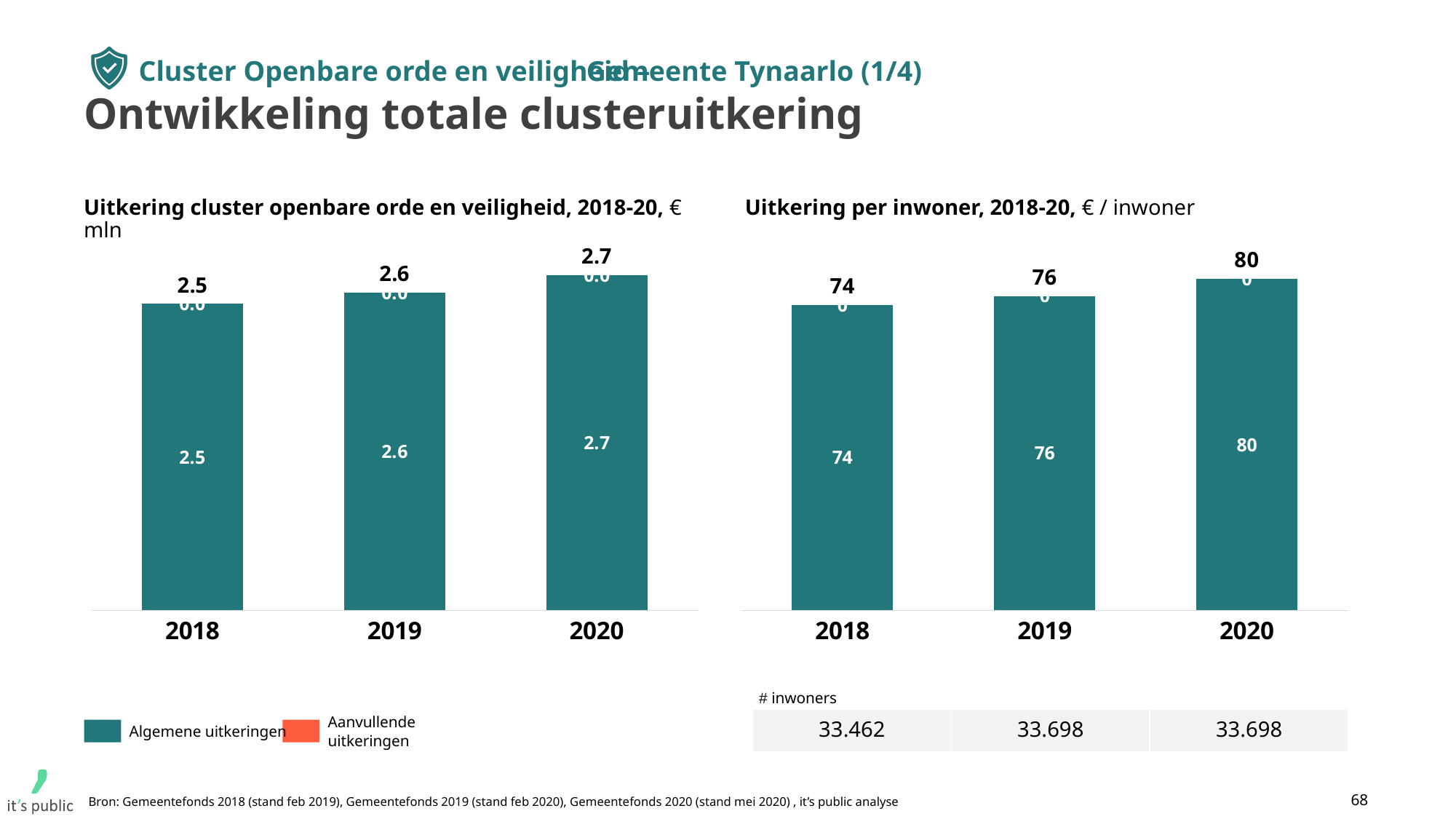
In the chart 'Uitkering per inwoner, 2018-20', which year has the lowest value? 2018 How many years are shown on the x axis of the chart 'Uitkering per inwoner, 2018-20'? 3 In the chart 'Uitkering cluster openbare orde en veiligheid, 2018-20', what is the total value for 2018? 2.5 What kind of chart is 'Uitkering per inwoner, 2018-20'? bar chart In the chart 'Uitkering per inwoner, 2018-20', what is the difference between the 2020 value and the 2018 value? 6 In the chart 'Uitkering cluster openbare orde en veiligheid, 2018-20', what is the difference between the 2020 total and the 2018 total? 0.2 How many series does the legend of the chart 'Uitkering cluster openbare orde en veiligheid, 2018-20' list? 2 In the chart 'Uitkering cluster openbare orde en veiligheid, 2018-20', which year has the highest total? 2020 In the chart 'Uitkering cluster openbare orde en veiligheid, 2018-20', do the totals rise or fall from 2018 to 2020? rise In the chart 'Uitkering per inwoner, 2018-20', is the value for 2019 larger or smaller than the value for 2020? smaller In the chart 'Uitkering per inwoner, 2018-20', what is the value for 2019? 76 In the chart 'Uitkering cluster openbare orde en veiligheid, 2018-20', what is the value of Algemene uitkeringen for 2020? 2.7